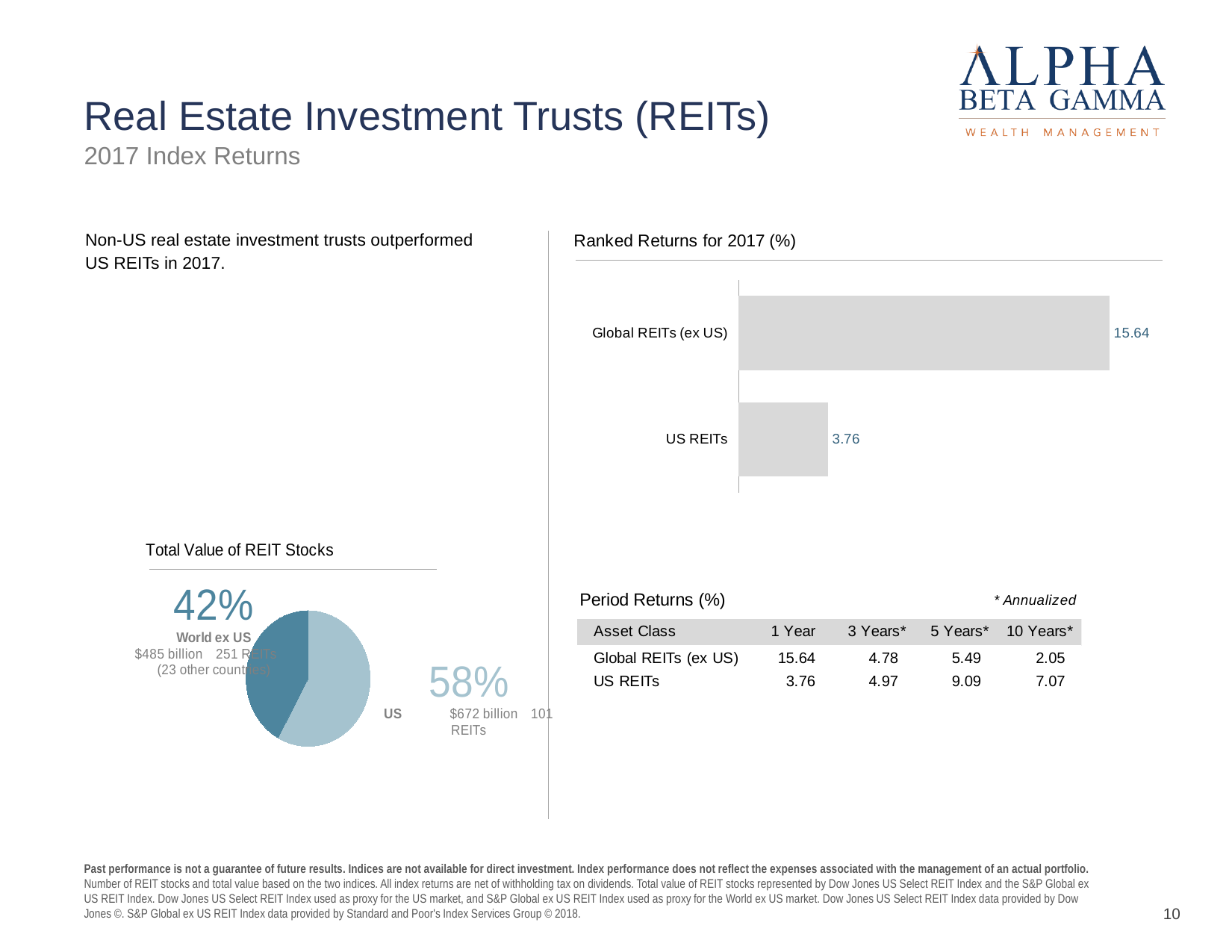
In the Ranked Returns for 2017 (%) chart, what is the value for Global REITs (ex US)? 15.64 In the Ranked Returns for 2017 (%) chart, what is the value for US REITs? 3.76 In the Total Value of REIT Stocks pie chart, which slice is larger, US or World ex US? US In the Ranked Returns for 2017 (%) chart, what is the difference between the Global REITs (ex US) and US REITs values? 11.88 In the Ranked Returns for 2017 (%) chart, which category has the lowest return? US REITs In the Ranked Returns for 2017 (%) chart, which category has the highest return? Global REITs (ex US) In the Ranked Returns for 2017 (%) chart, which is larger, Global REITs (ex US) or US REITs? Global REITs (ex US) In the Total Value of REIT Stocks pie chart, what share does the US slice represent? 58% In the Total Value of REIT Stocks pie chart, what share does the World ex US slice represent? 42% What kind of chart is the Total Value of REIT Stocks chart? Pie chart How many categories are shown in the Ranked Returns for 2017 (%) chart? 2 What kind of chart is the Ranked Returns for 2017 (%) chart? Bar chart